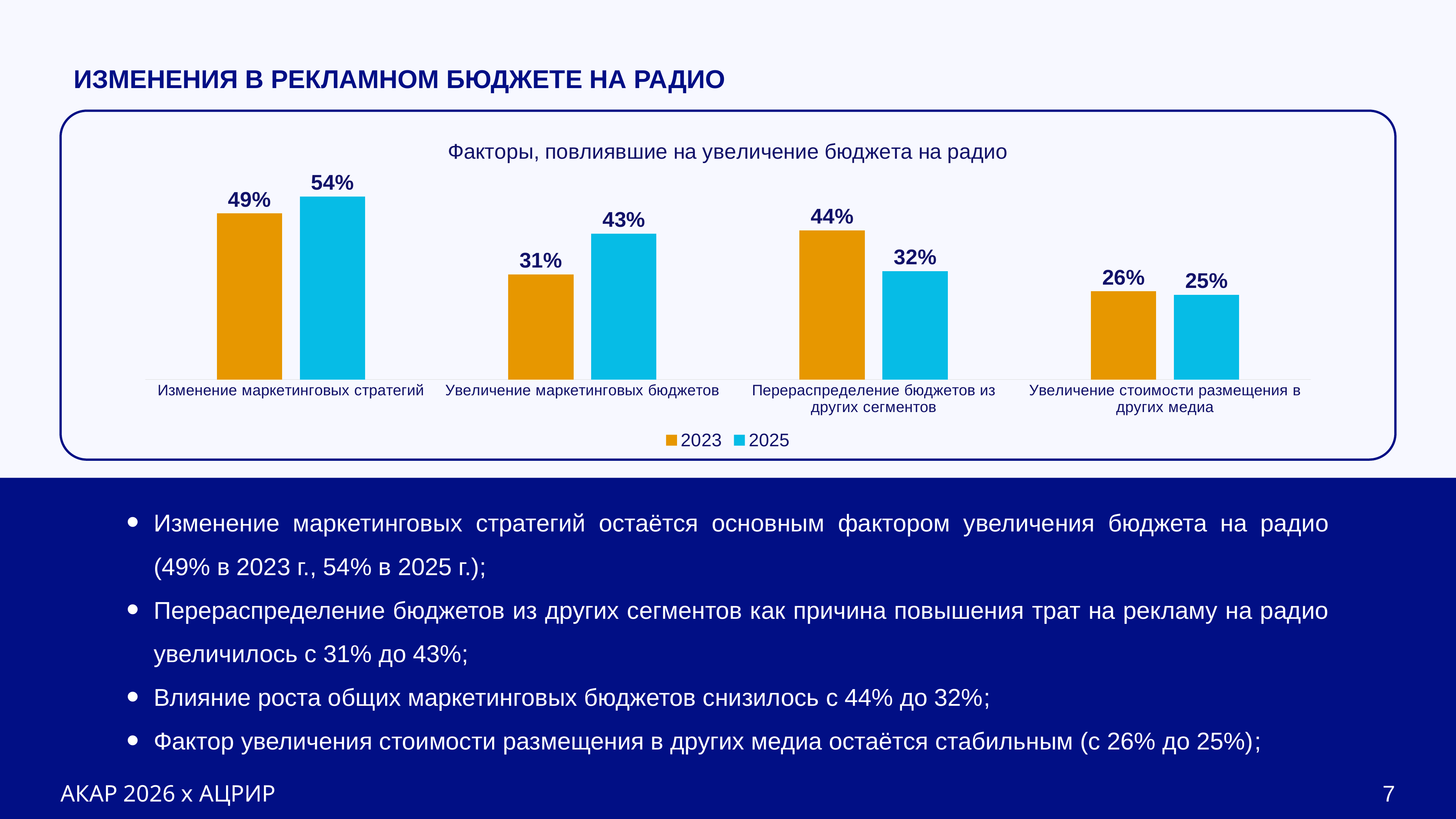
How many series does the legend list? 2 Which category has the lowest 2023 value? Увеличение стоимости размещения в других медиа For «Перераспределение бюджетов из других сегментов», which year has the larger value, 2023 or 2025? 2023 What is the 2025 value for «Перераспределение бюджетов из других сегментов»? 32% What is the 2023 value for «Увеличение стоимости размещения в других медиа»? 26% What is the 2025 value for «Изменение маркетинговых стратегий»? 54% How many categories are shown on the x axis? 4 What is the difference between the 2025 and 2023 values for «Увеличение маркетинговых бюджетов»? 12% What is the title of the chart? Факторы, повлиявшие на увеличение бюджета на радио What kind of chart is shown? Bar chart Which category has the highest 2025 value? Изменение маркетинговых стратегий What is the 2023 value for «Увеличение маркетинговых бюджетов»? 31%